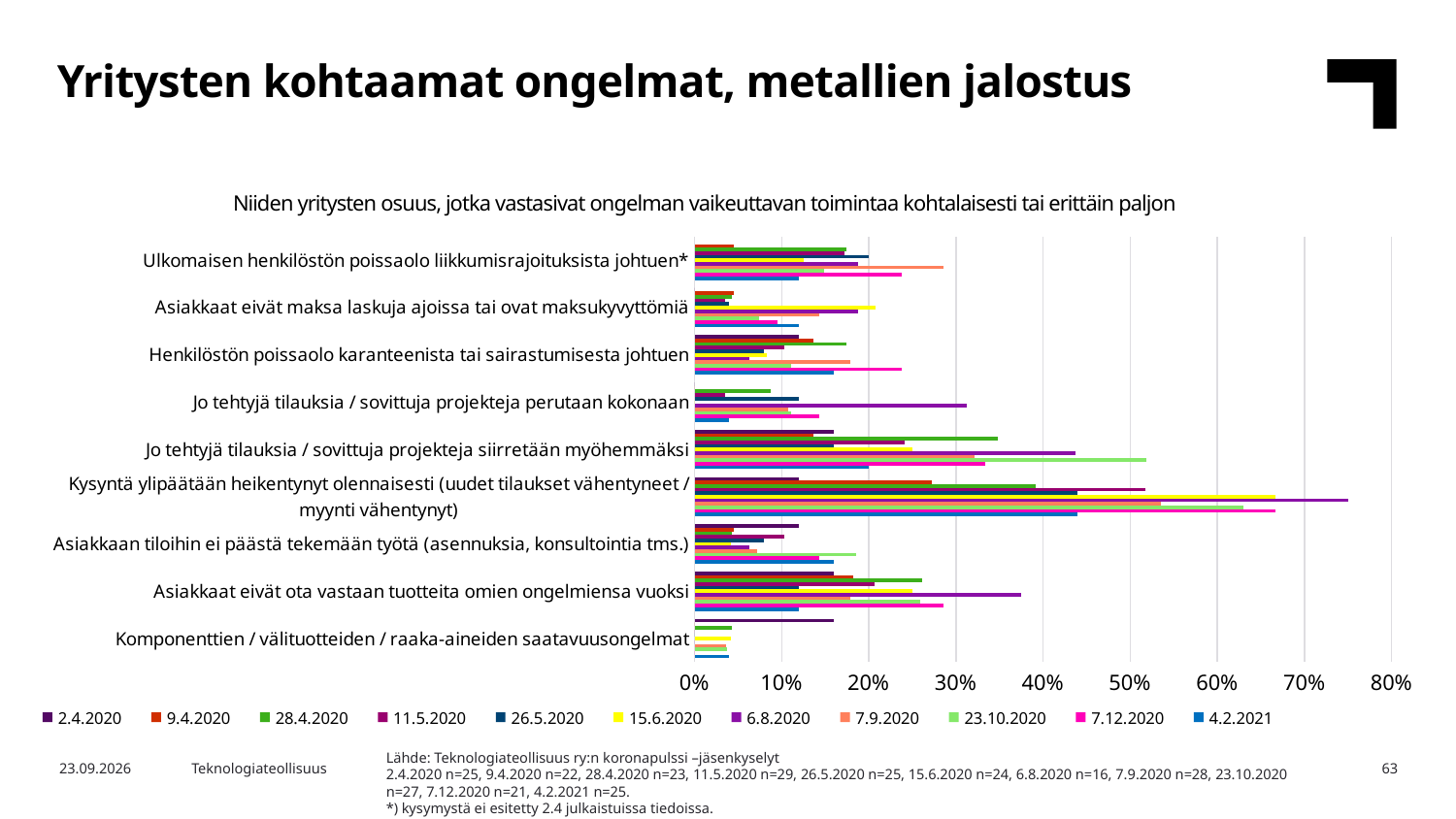
Is the 23.10.2020 value for 'Jo tehtyjä tilauksia / sovittuja projekteja siirretään myöhemmäksi' greater or less than 40%? greater What is the chart's title? Niiden yritysten osuus, jotka vastasivat ongelman vaikeuttavan toimintaa kohtalaisesti tai erittäin paljon Which category contains the longest bar on the chart? Kysyntä ylipäätään heikentynyt olennaisesti (uudet tilaukset vähentyneet / myynti vähentynyt) For 'Asiakkaat eivät ota vastaan tuotteita omien ongelmiensa vuoksi', which is larger: the 6.8.2020 value or the 2.4.2020 value? 6.8.2020 How many problem categories are plotted on the chart? 9 What is the highest value shown on the horizontal axis? 80% Is the 7.9.2020 value for 'Ulkomaisen henkilöstön poissaolo liikkumisrajoituksista johtuen*' greater or less than 20%? greater Is the 6.8.2020 value for 'Kysyntä ylipäätään heikentynyt olennaisesti' greater or less than 70%? greater What kind of chart is shown on the slide? Bar chart How many series does the legend list? 11 For the category 'Kysyntä ylipäätään heikentynyt olennaisesti', which series has the highest value? 6.8.2020